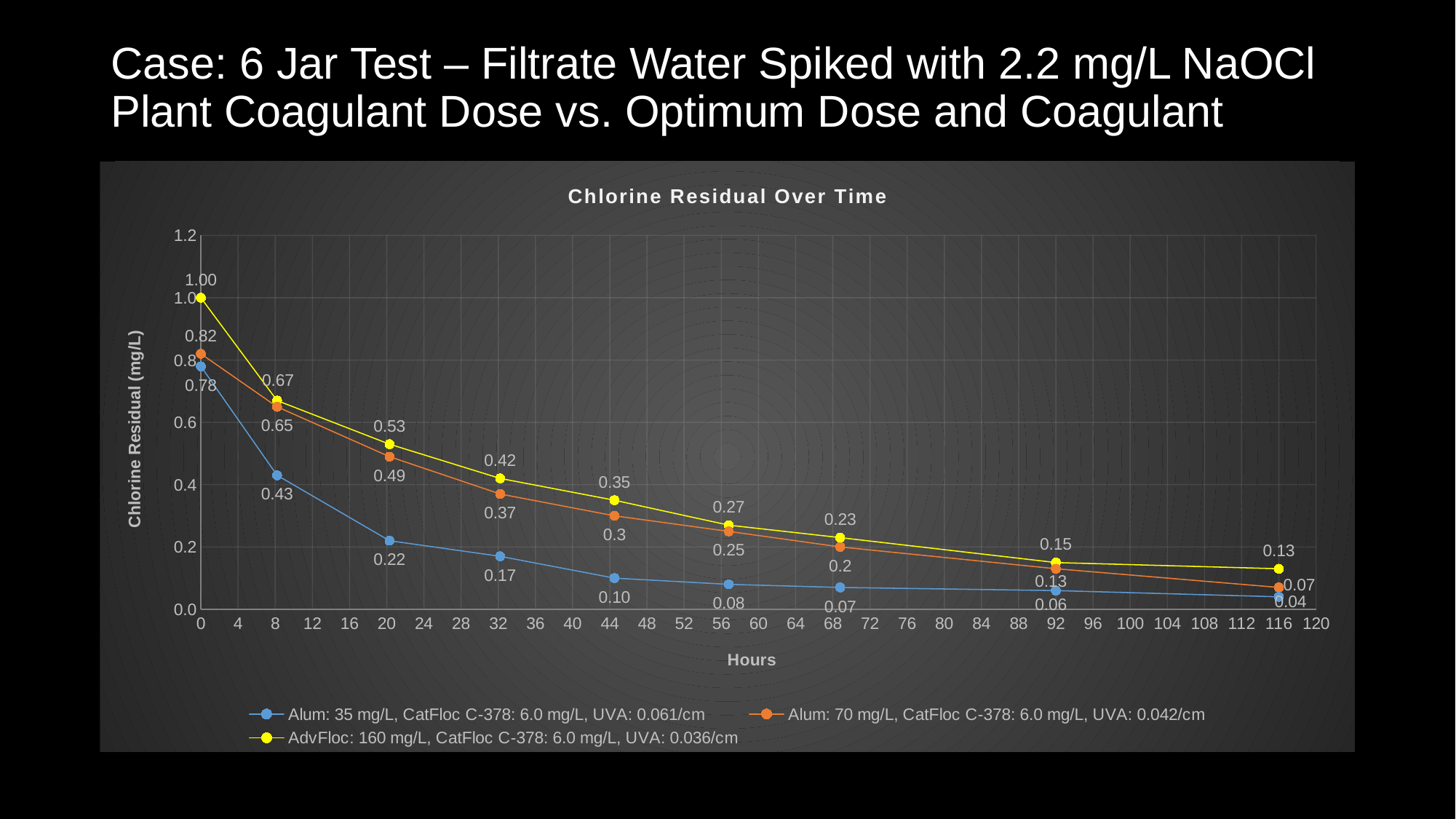
Which series has the highest chlorine residual at 116 hours? AdvFloc: 160 mg/L, CatFloc C-378: 6.0 mg/L, UVA: 0.036/cm What is the chlorine residual for the Alum: 70 mg/L series at 8 hours? 0.65 What kind of chart is shown on the slide? Line chart What is the title of the chart? Chlorine Residual Over Time Is the value for the Alum: 35 mg/L series at 8 hours greater or less than 0.6? less What is the chlorine residual for the Alum: 35 mg/L series at 116 hours? 0.04 At 20 hours, which series has the larger chlorine residual: Alum: 70 mg/L or Alum: 35 mg/L? Alum: 70 mg/L, CatFloc C-378: 6.0 mg/L, UVA: 0.042/cm What is the chlorine residual for the AdvFloc: 160 mg/L series at 0 hours? 1.00 Do the chlorine residual values rise or fall as hours increase? Fall How many series does the legend list? 3 How many data points are plotted for the AdvFloc: 160 mg/L series? 9 What is the difference between the AdvFloc: 160 mg/L value and the Alum: 70 mg/L value at 0 hours? 0.18